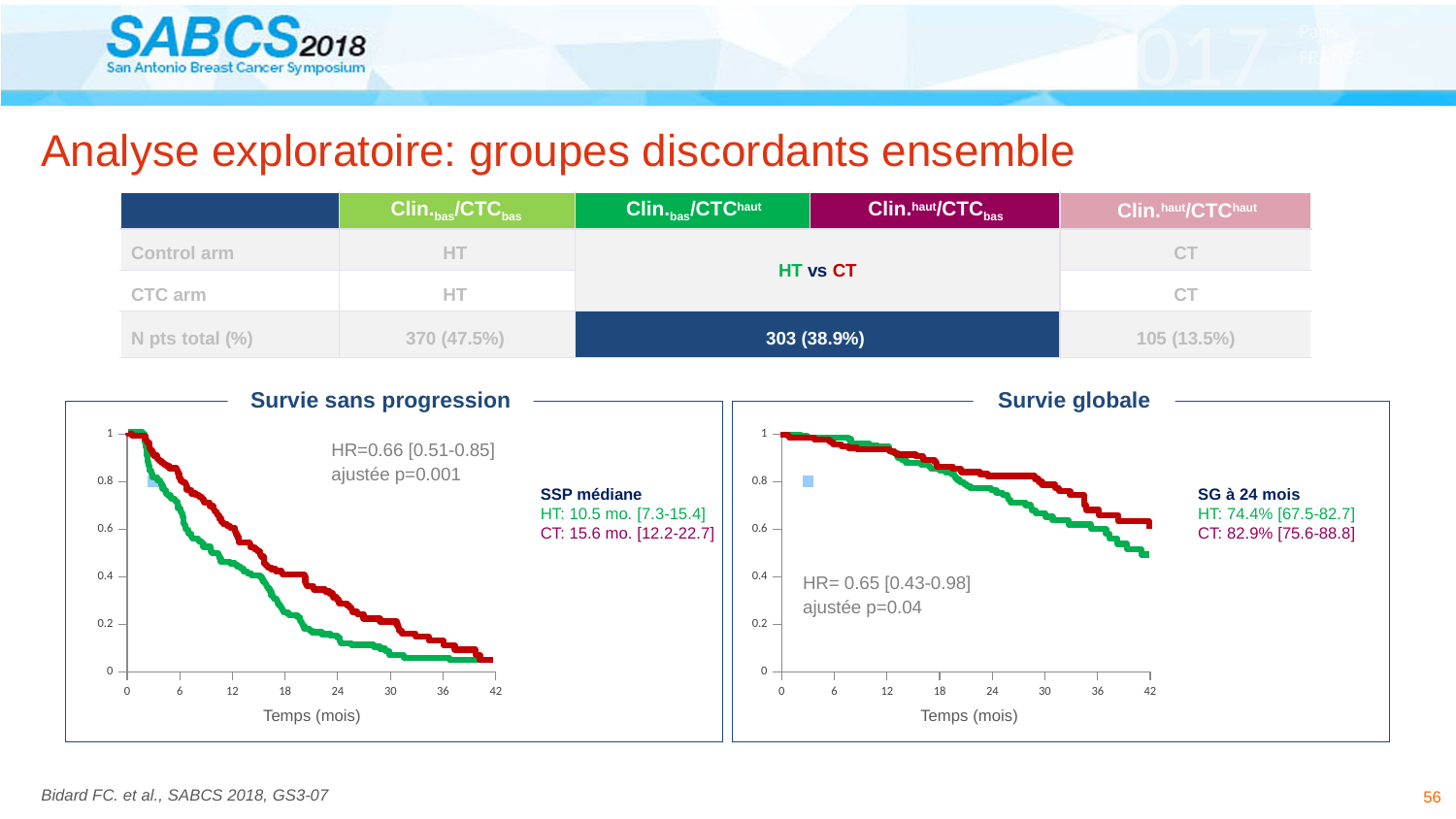
In the 'Survie globale' chart, do the survival curves rise or fall as time increases? fall What is the x-axis label on the 'Survie sans progression' chart? Temps (mois) In the 'Survie sans progression' chart, what is the difference in median PFS between the CT and HT arms? 5.1 mo. In the 'Survie sans progression' chart, what is the median PFS for the HT arm? 10.5 mo. In the 'Survie sans progression' chart, what is the median PFS for the CT arm? 15.6 mo. What kind of chart is the 'Survie sans progression' chart? line chart In the 'Survie sans progression' chart, what hazard ratio is reported? HR=0.66 [0.51-0.85] In the 'Survie globale' chart, what adjusted p-value is reported? p=0.04 In the 'Survie globale' chart, what is the overall survival at 24 months for the HT arm? 74.4% In the 'Survie sans progression' chart, which arm has the higher median PFS, HT or CT? CT In the 'Survie globale' chart, what is the overall survival at 24 months for the CT arm? 82.9% In the 'Survie globale' chart, what is the difference in 24-month survival between the CT and HT arms? 8.5 percentage points